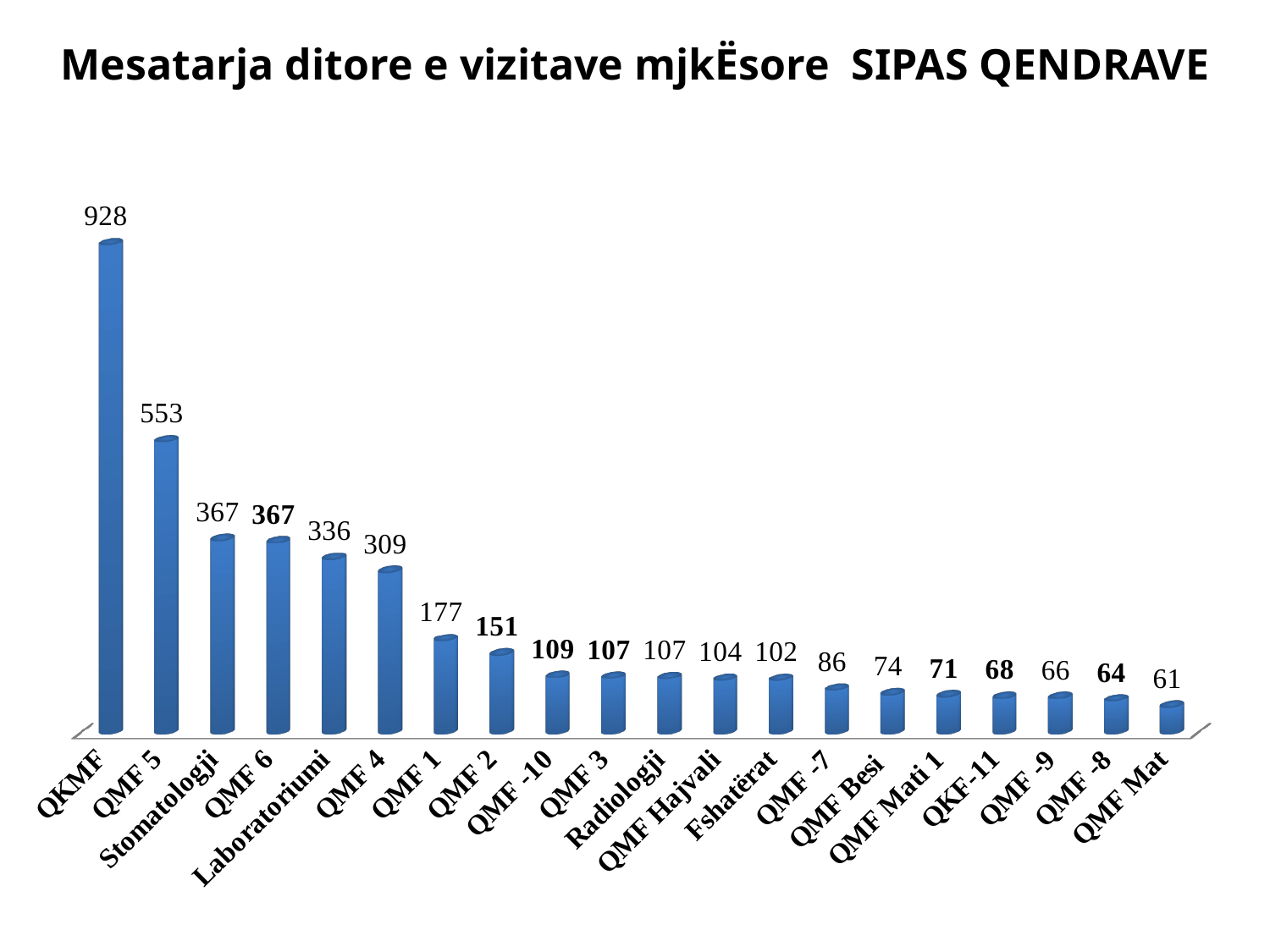
How many categories are shown in the chart? 20 What kind of chart is shown on the slide? Bar chart Which category has the lowest value? QMF Mat Do the values rise or fall from left to right along the x axis? Fall Which category has the highest value? QKMF What is the value for QKF -11? 68 Which is larger, the value for QMF 4 or the value for QMF 1? QMF 4 What is the value for QKMF? 928 What is the value for QMF Hajvali? 104 What is the difference between the values for QMF 1 and QMF 2? 26 What is the difference between the values for QKMF and QMF 5? 375 What is the value for Laboratoriumi? 336